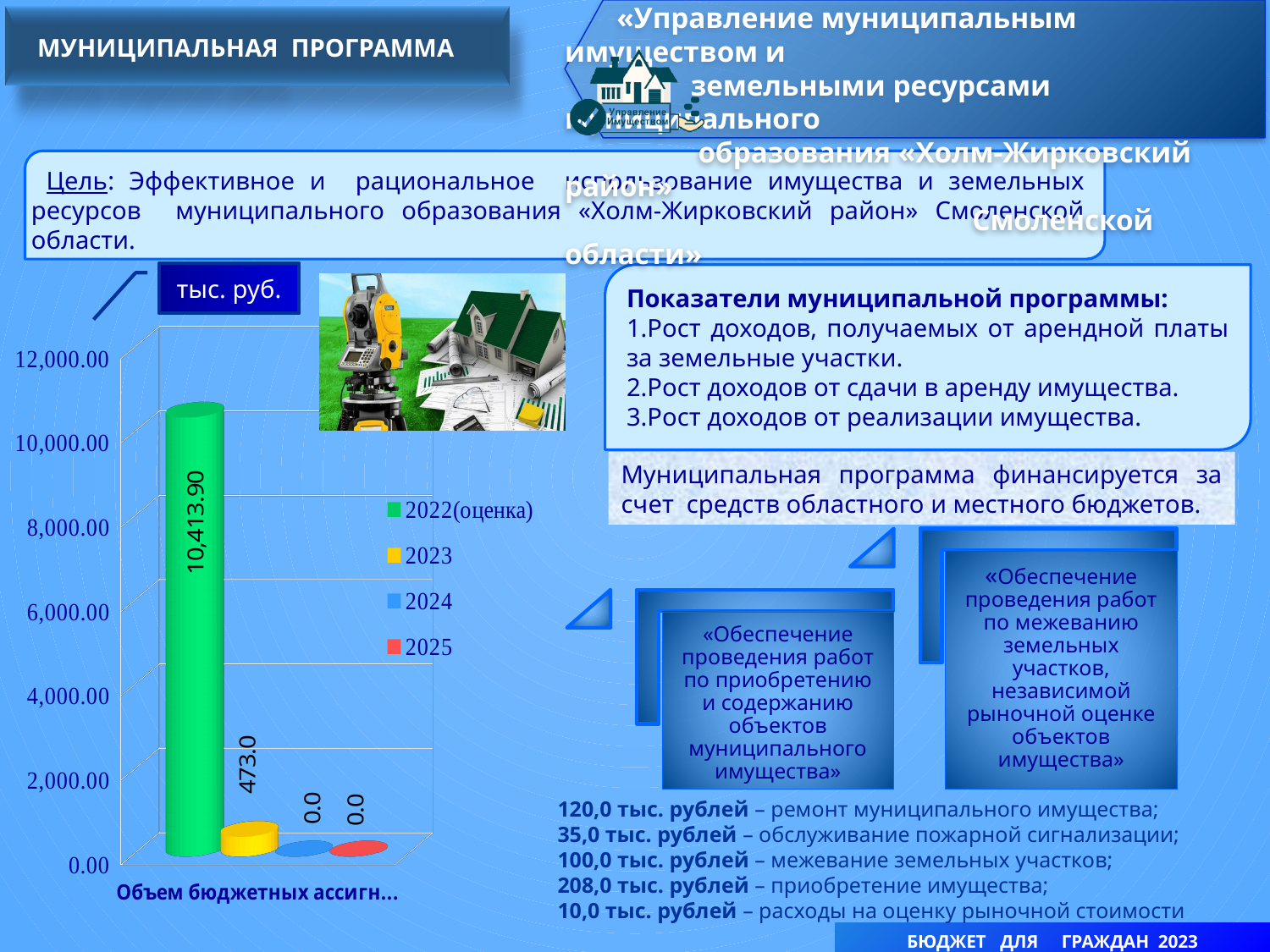
Which series has the highest value in the chart? 2022(оценка) What is the value for the 2022(оценка) series in the chart? 10,413.90 Which is larger, the value for 2022(оценка) or the value for 2023? 2022(оценка) What is the difference between the 2022(оценка) value and the 2023 value? 9,940.90 What is the value for the 2024 series in the chart? 0.0 Is the value for 2023 greater or less than 2,000.00? less How many series does the chart legend list? 4 What unit is shown in the label above the chart? тыс. руб. What kind of chart is shown on the slide? bar chart Is the value for 2022(оценка) greater or less than 10,000.00? greater What is the value for the 2023 series in the chart? 473.0 What is the value for the 2025 series in the chart? 0.0